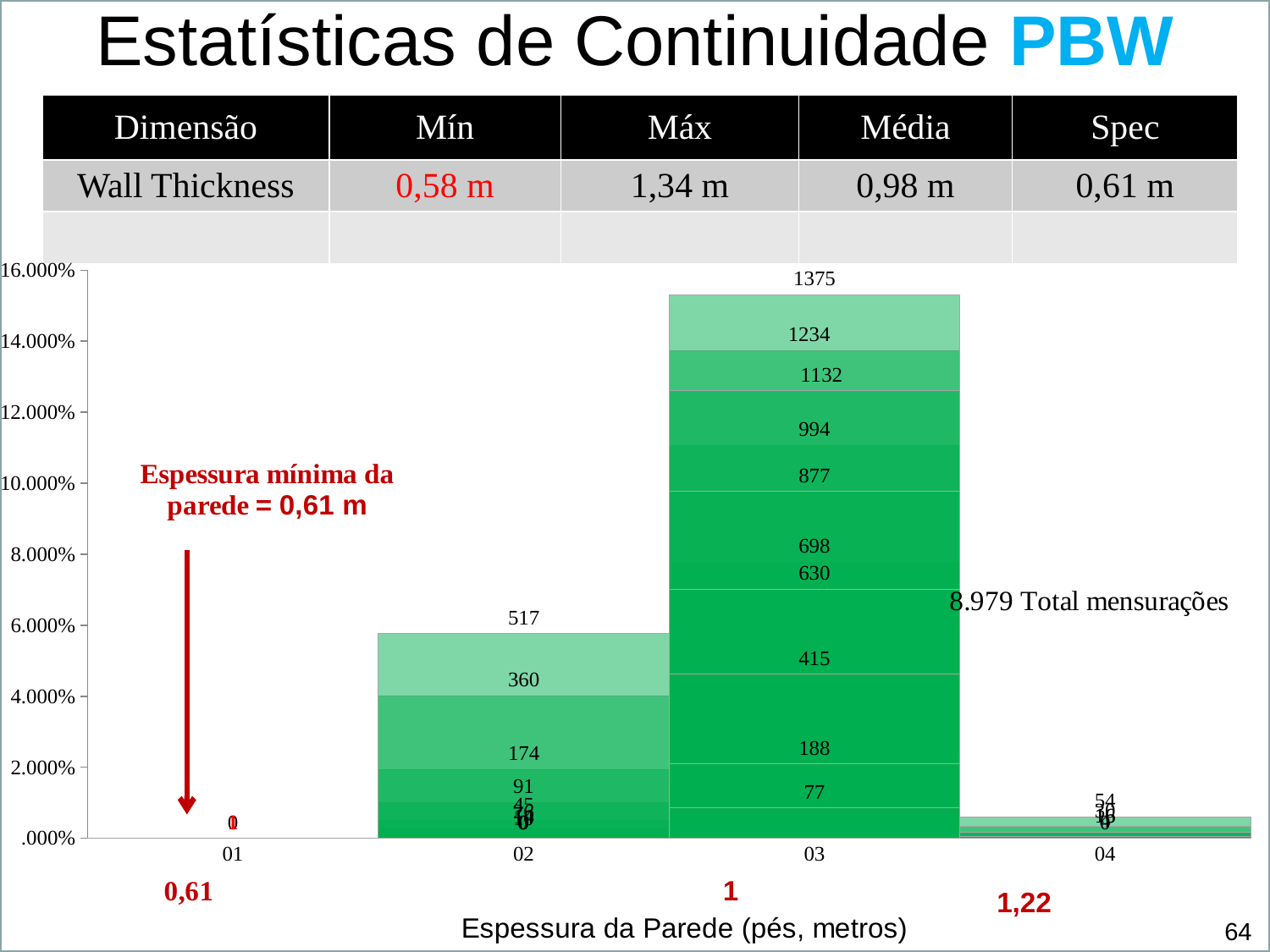
Which category has the shortest bar in the chart? 01 What is the topmost data label printed on the bar for category 02? 517 What is the difference between the topmost label on bar 03 (1375) and the topmost label on bar 02 (517)? 858 Is the total height of the bar for category 04 greater or less than 2.000%? less What is the lowest data label printed on the bar for category 03? 77 How many categories are shown on the x axis of the chart? 4 What kind of chart is shown on the slide? bar chart What is the x-axis title of the chart? Espessura da Parede (pés, metros) Which category has the tallest bar in the chart? 03 Is the total height of the bar for category 02 greater or less than 4.000%? greater What is the topmost data label printed on the bar for category 03? 1375 Which bar is taller, category 02 or category 04? 02